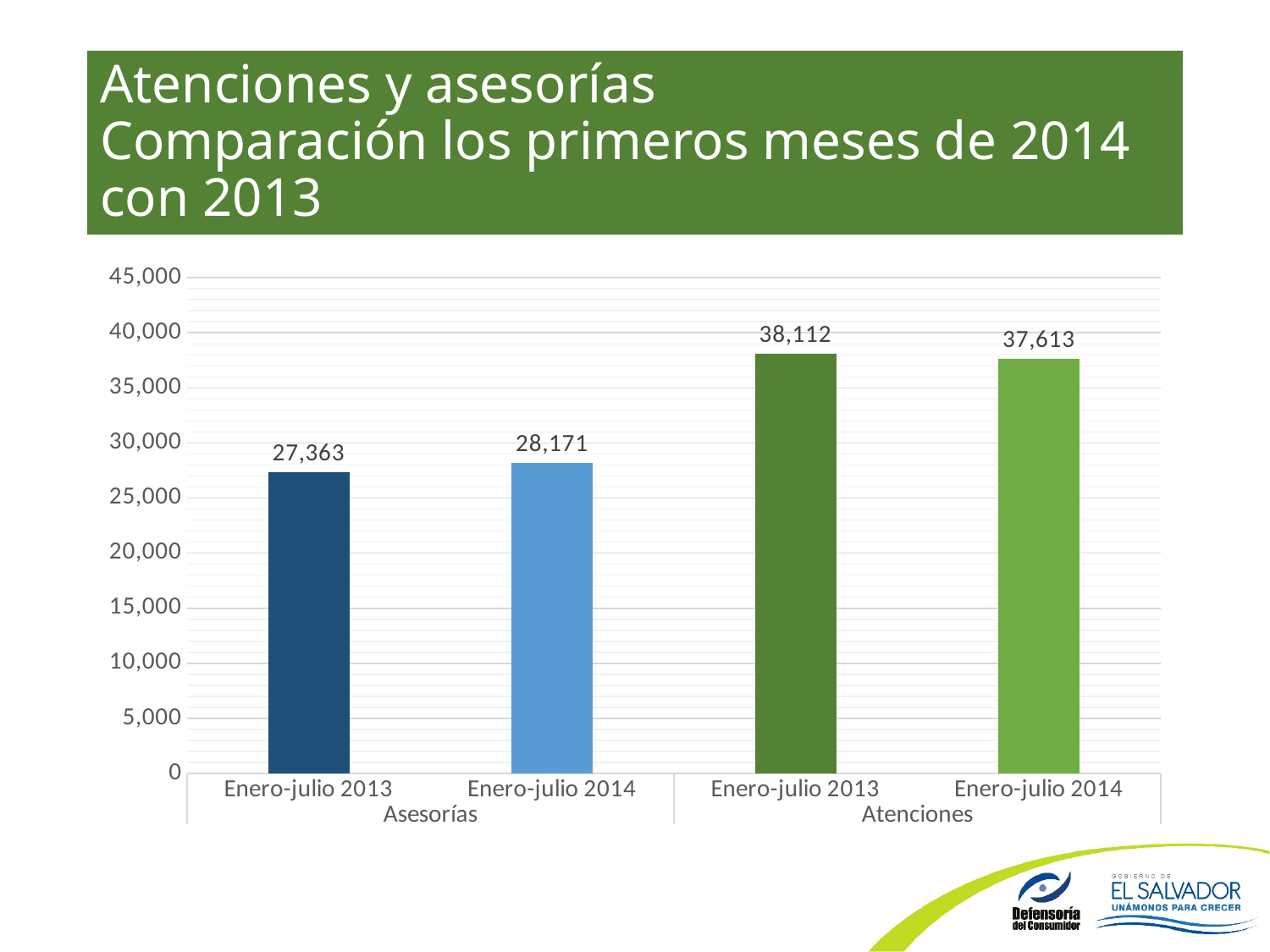
What is the difference between Asesorías Enero-julio 2014 and Asesorías Enero-julio 2013? 808 What is the difference between Atenciones Enero-julio 2013 and Atenciones Enero-julio 2014? 499 Is the value for Atenciones Enero-julio 2013 greater or less than 35,000? greater How many bars are plotted in the chart? 4 What is the value for Asesorías Enero-julio 2014? 28,171 What is the value for Asesorías Enero-julio 2013? 27,363 Which bar has the lowest value? Asesorías Enero-julio 2013 Which bar has the highest value? Atenciones Enero-julio 2013 What is the value for Atenciones Enero-julio 2014? 37,613 What kind of chart is shown on the slide? bar chart Which is larger, Asesorías Enero-julio 2014 or Atenciones Enero-julio 2014? Atenciones Enero-julio 2014 What is the value for Atenciones Enero-julio 2013? 38,112